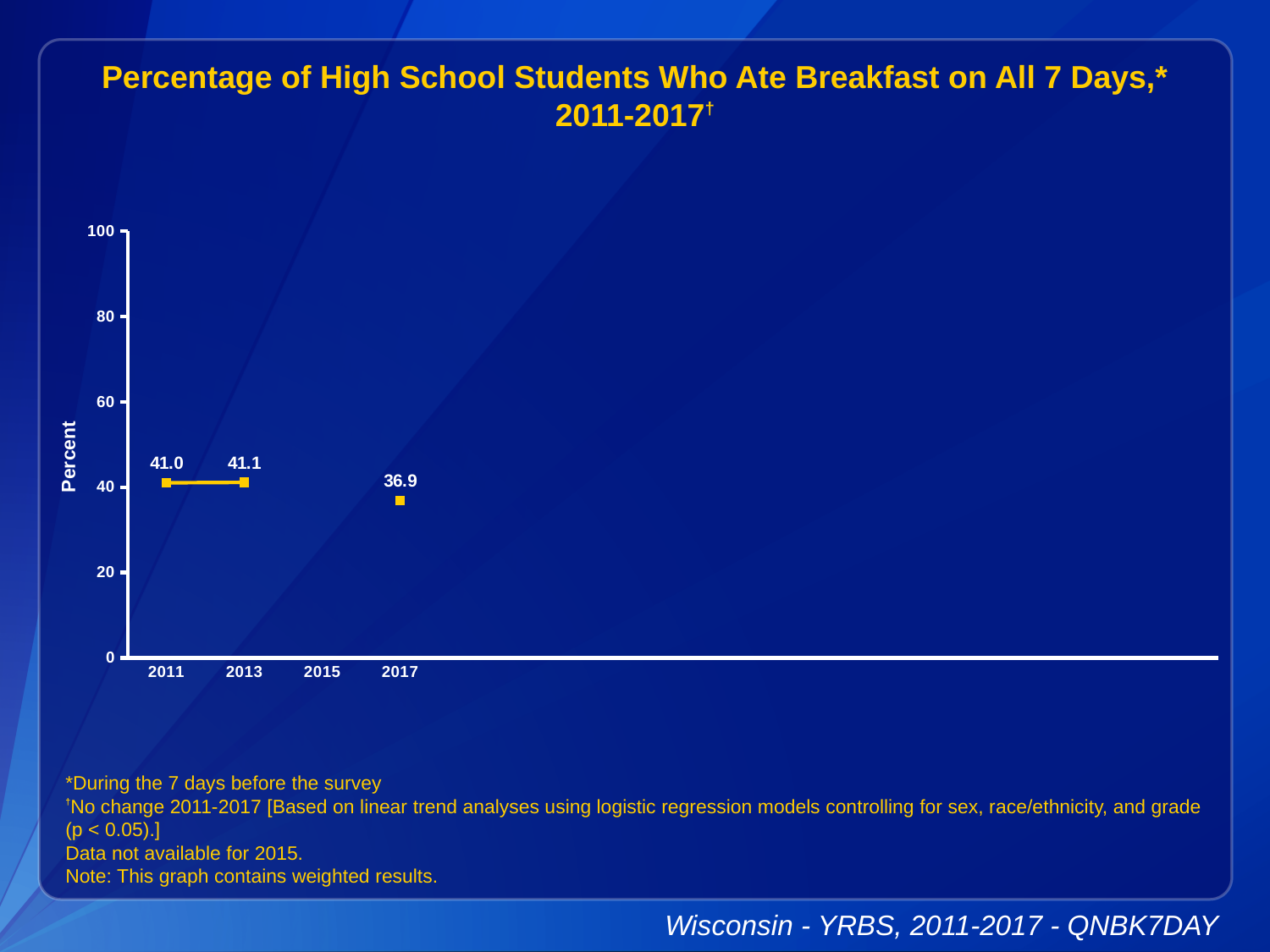
Is the value for 2017 greater or less than 40? less What kind of chart is shown? line chart What is the value for 2017? 36.9 What is the value for 2013? 41.1 Is the value for 2013 greater or less than 60? less What is the difference between the values for 2013 and 2017? 4.2 Which is larger, the value for 2011 or the value for 2017? 2011 What is the difference between the values for 2011 and 2017? 4.1 Which year has the lowest value? 2017 What is the label on the y axis? Percent How many years have a plotted data point? 3 What is the value for 2011? 41.0